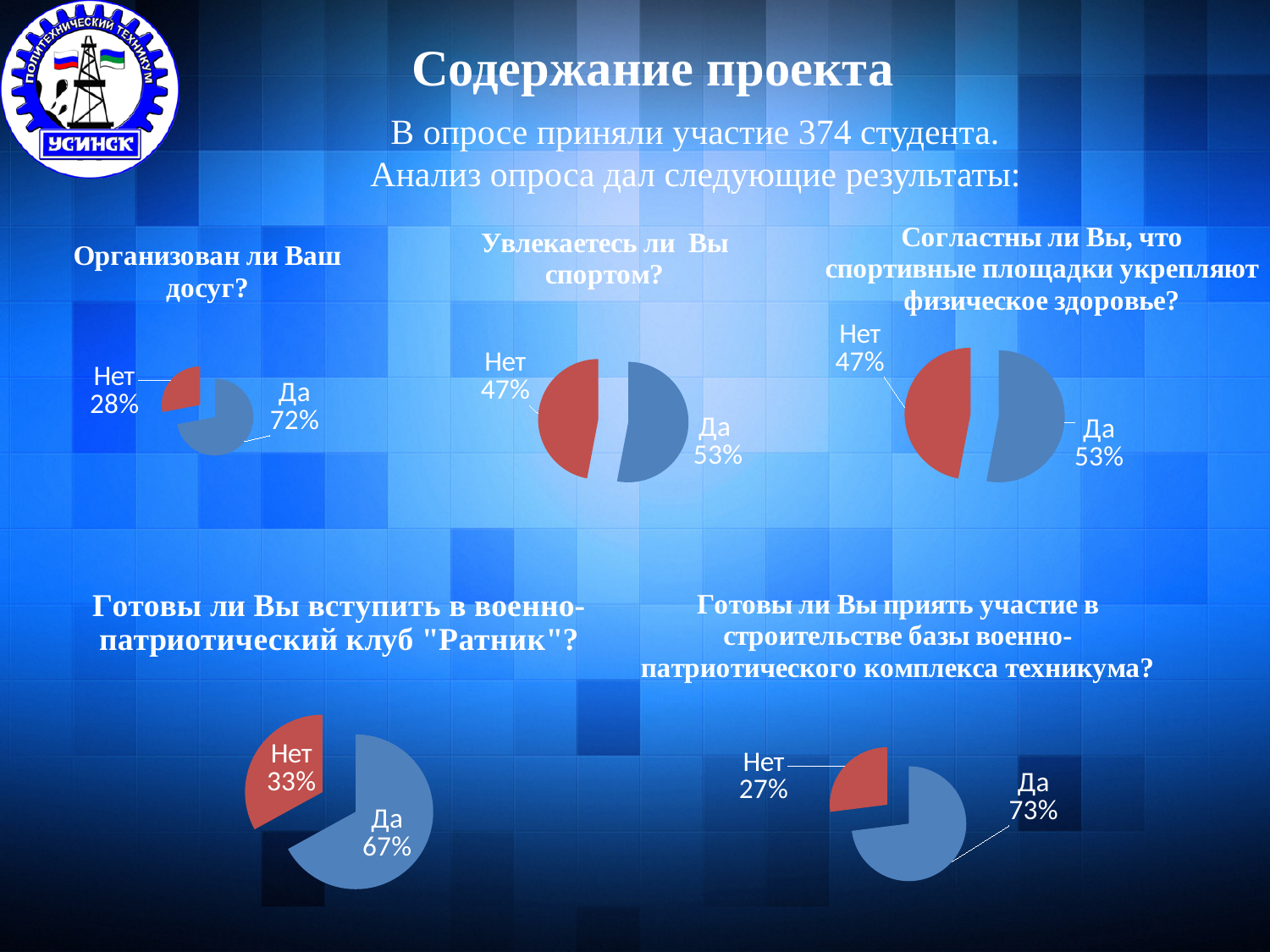
In the chart titled "Согластны ли Вы, что спортивные площадки укрепляют физическое здоровье?", what is the difference between the "Да" and "Нет" shares? 6% In the chart titled "Организован ли Ваш досуг?", what is the value for "Нет"? 28% How many slices does the chart titled "Увлекаетесь ли Вы спортом?" have? 2 In the chart titled "Готовы ли Вы приять участие в строительстве базы военно-патриотического комплекса техникума?", what is the difference between the "Да" and "Нет" shares? 46% In the chart titled "Согластны ли Вы, что спортивные площадки укрепляют физическое здоровье?", what is the value for "Да"? 53% In the chart titled "Готовы ли Вы вступить в военно-патриотический клуб "Ратник"?", which answer has the largest slice? Да In the chart titled "Увлекаетесь ли Вы спортом?", what share of the pie is "Нет"? 47% In the chart titled "Организован ли Ваш досуг?", what share of respondents answered "Да"? 72% In the chart titled "Готовы ли Вы вступить в военно-патриотический клуб "Ратник"?", what share answered "Нет"? 33% What type of chart is used for "Организован ли Ваш досуг?"? Pie chart In the chart titled "Готовы ли Вы приять участие в строительстве базы военно-патриотического комплекса техникума?", what is the value for "Да"? 73% In the chart titled "Увлекаетесь ли Вы спортом?", which slice is larger, "Да" or "Нет"? Да